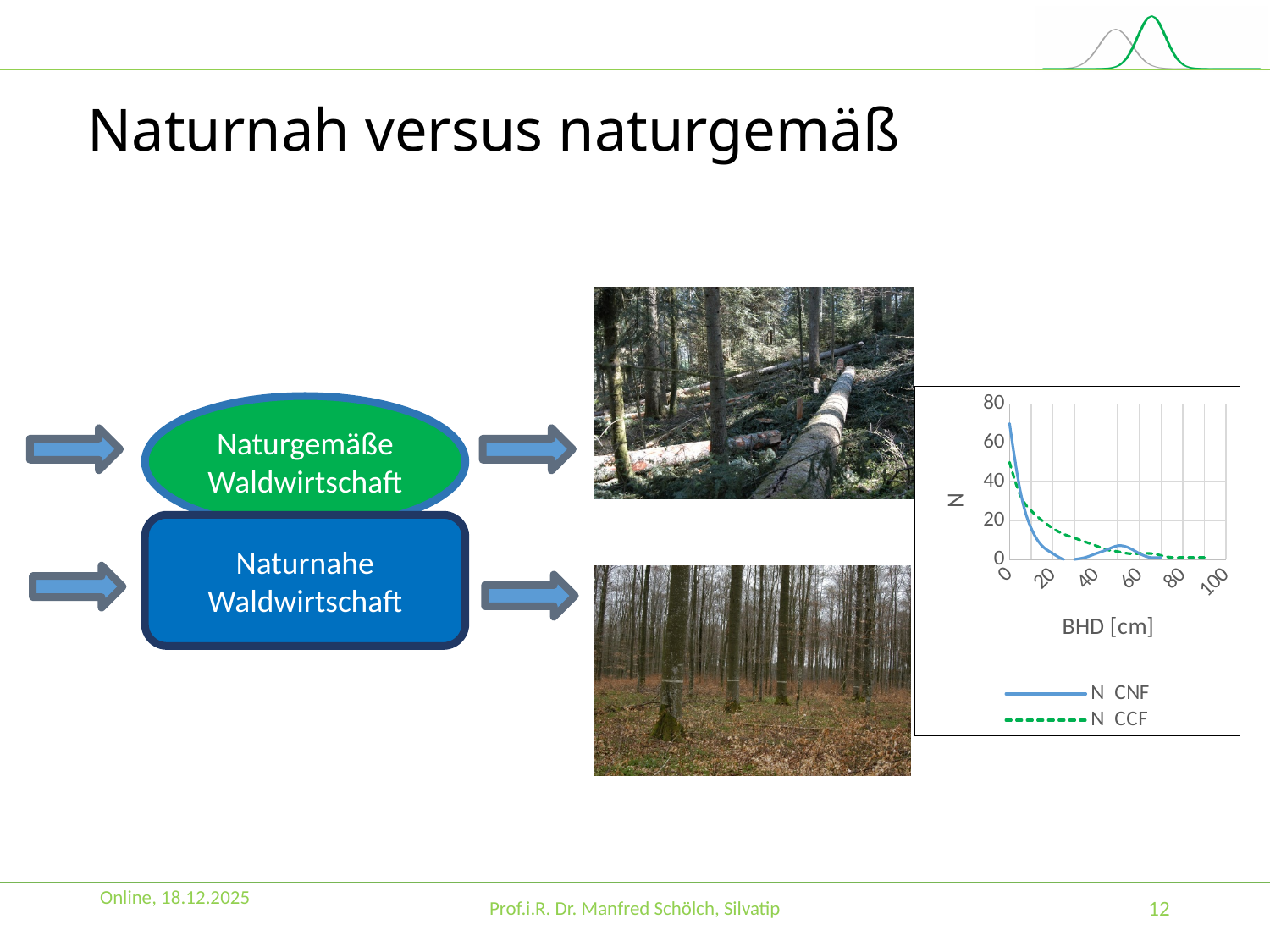
At BHD 0, which series has the higher value, N CNF or N CCF? N CNF How many tick labels are shown on the x axis of the chart? 6 Is the value of N CNF at BHD 20 greater or less than 20? less How many series does the chart legend list? 2 What kind of chart is shown on the slide? line chart Is the value of N CCF at BHD 80 greater or less than 20? less At BHD 40, which series has the higher value, N CNF or N CCF? N CCF What is the label of the x axis of the chart? BHD [cm] Is the value of N CNF at BHD 0 greater or less than 60? greater What are the two series named in the chart legend? N CNF and N CCF Does the N CCF series rise or fall as BHD increases? fall